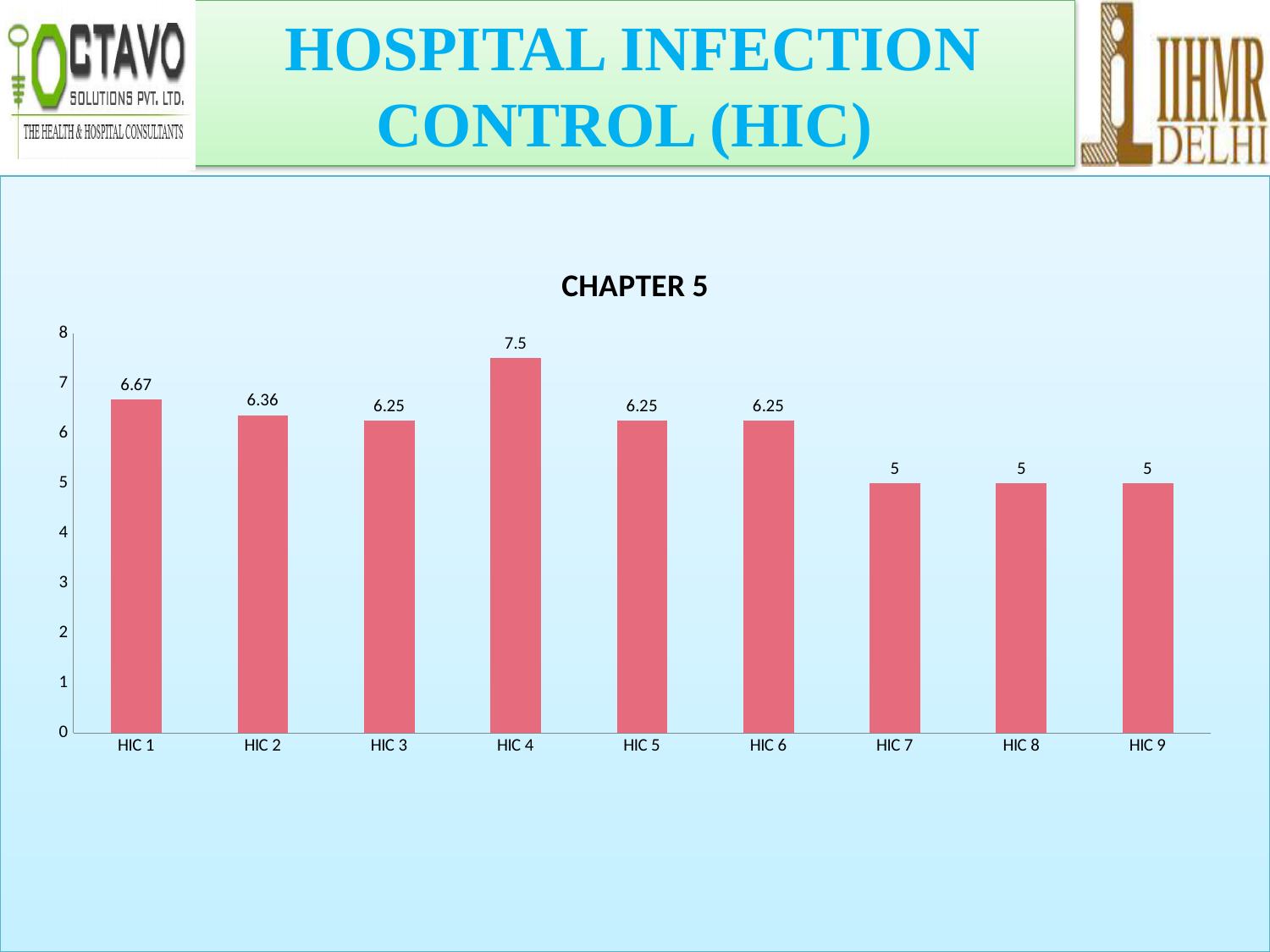
What is the title of the chart? CHAPTER 5 Is the value for HIC 4 greater or less than 7? greater What is the value for HIC 2? 6.36 What is the value for HIC 4? 7.5 Which is larger, the value for HIC 2 or the value for HIC 5? HIC 2 How many categories are shown on the x axis? 9 What is the difference between the values for HIC 3 and HIC 7? 1.25 What is the value for HIC 1? 6.67 What is the difference between the values for HIC 4 and HIC 1? 0.83 Which category has the highest value? HIC 4 What kind of chart is shown on the slide? Bar chart What is the value for HIC 8? 5